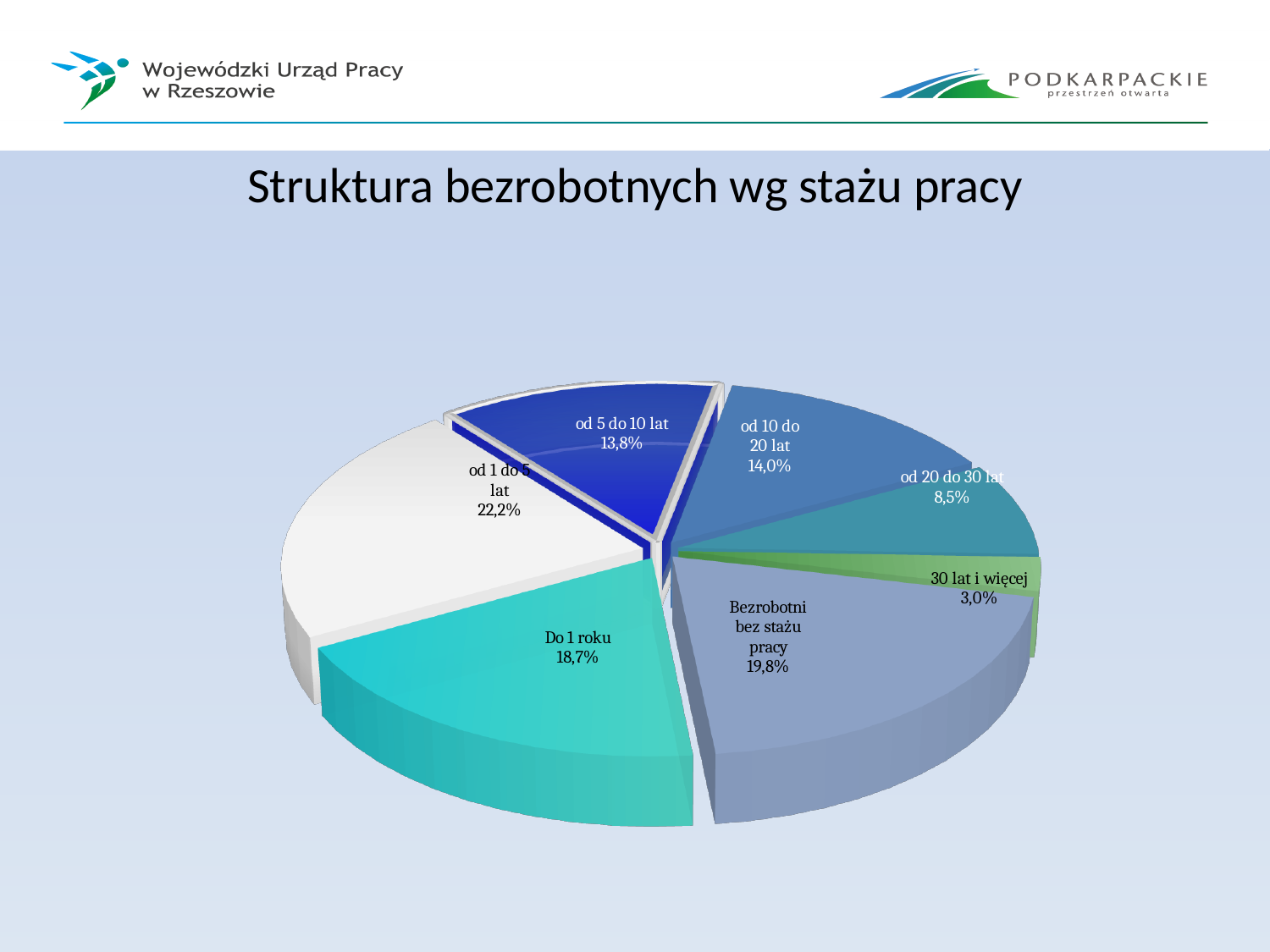
What is the value shown for "Bezrobotni bez stażu pracy"? 19,8% What kind of chart is shown on the slide? pie chart What is the difference in percentage points between "od 1 do 5 lat" and "od 20 do 30 lat"? 13,7 What is the difference in percentage points between "od 10 do 20 lat" and "od 5 do 10 lat"? 0,2 Which is larger, the share for "od 20 do 30 lat" or the share for "Do 1 roku"? Do 1 roku What is the title of the chart? Struktura bezrobotnych wg stażu pracy What share of the pie is labelled "od 1 do 5 lat"? 22,2% What is the value shown for "Do 1 roku"? 18,7% Which category has the smallest share of the pie? 30 lat i więcej How many slices does the pie chart have? 7 Which category has the largest share of the pie? od 1 do 5 lat What is the value shown for "30 lat i więcej"? 3,0%